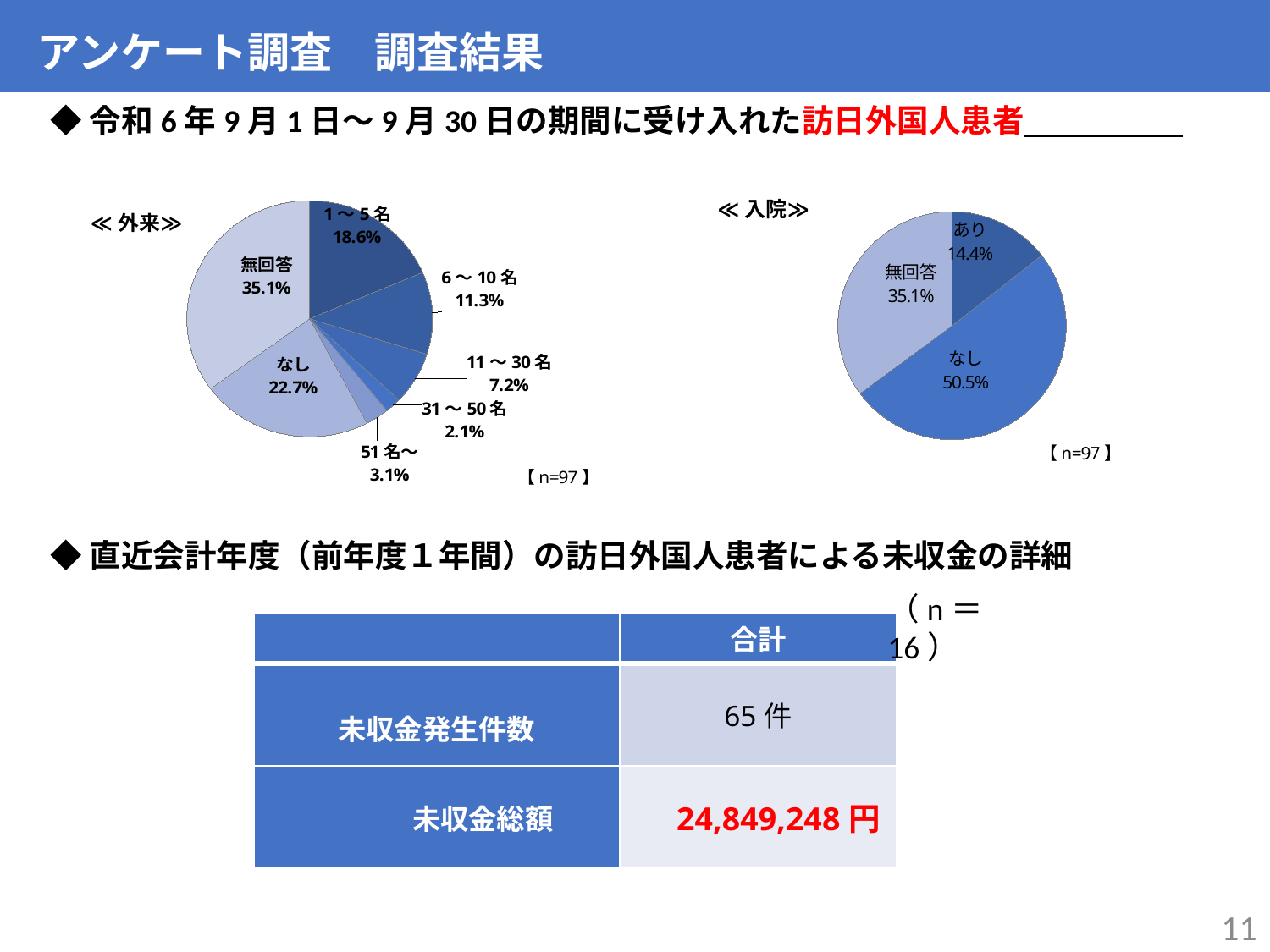
In the ≪外来≫ pie chart, what share is labelled for 無回答? 35.1% In the ≪外来≫ pie chart, which category has the largest share? 無回答 In the ≪入院≫ pie chart, which category has the largest share? なし What kind of chart is the ≪入院≫ chart? Pie chart In the ≪外来≫ pie chart, which is larger: 11～30名 or 51名～? 11～30名 In the ≪外来≫ pie chart, what share is labelled for 1～5名? 18.6% In the ≪外来≫ pie chart, what is the difference in percentage points between なし and 6～10名? 11.4 In the ≪外来≫ pie chart, which category has the smallest share? 31～50名 How many categories does the ≪外来≫ pie chart show? 7 In the ≪外来≫ pie chart, what share is labelled for 31～50名? 2.1% In the ≪入院≫ pie chart, what share is labelled for なし? 50.5% In the ≪入院≫ pie chart, what share is labelled for あり? 14.4%